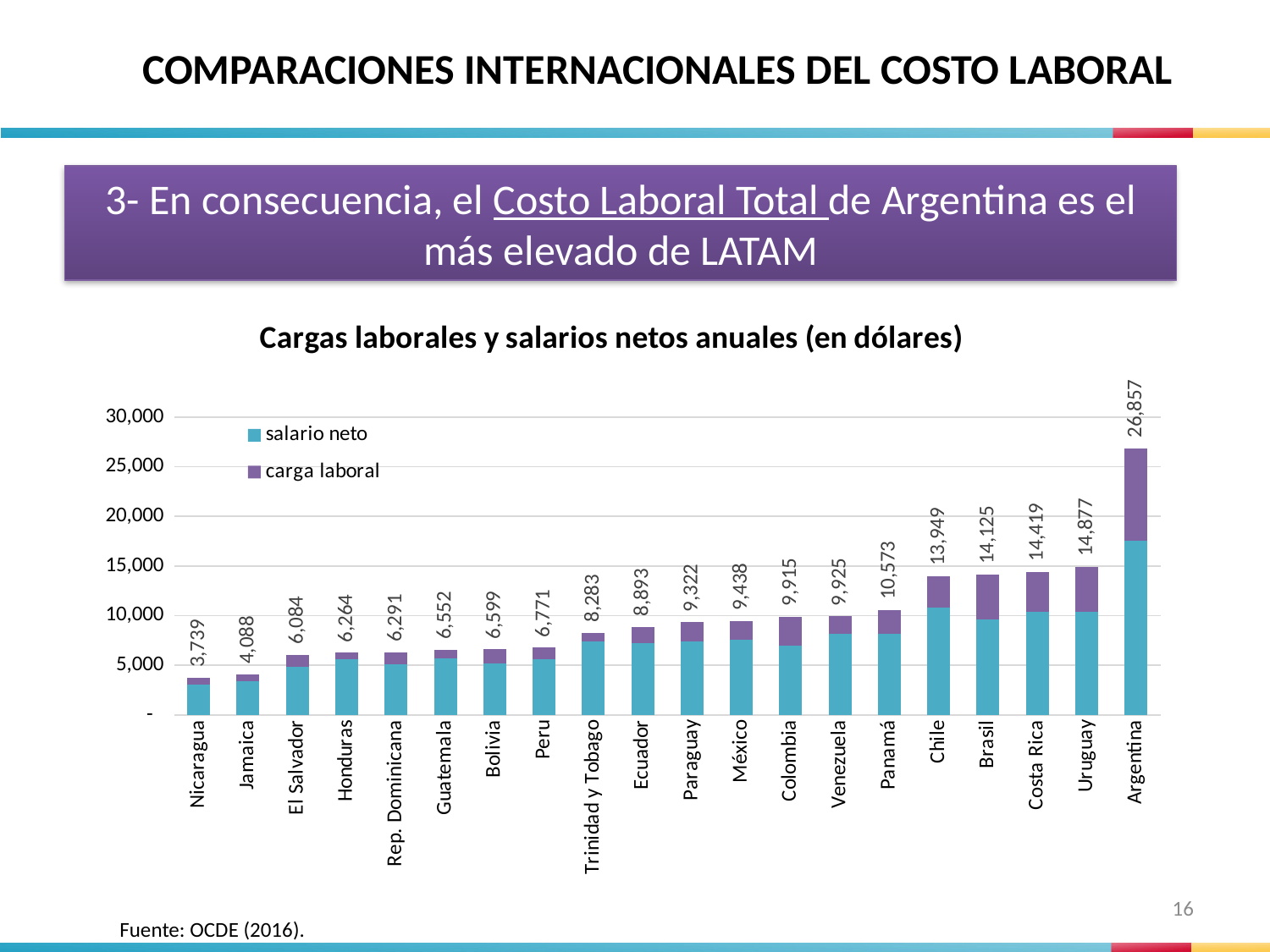
Which has a larger total value, Panamá or Venezuela? Panamá What kind of chart is shown on the slide? Stacked bar chart Is the salario neto value for Argentina greater or less than 15,000? greater How many series does the legend list? 2 What is the difference between the total values for Argentina and Uruguay? 11,980 Which country has the lowest total value in the chart? Nicaragua Do the total values rise or fall from left to right along the x axis? Rise Which country has the highest total value in the chart? Argentina What is the total labeled value for Argentina? 26,857 How many countries are shown in the chart? 20 What is the total labeled value for Nicaragua? 3,739 What is the total labeled value for Chile? 13,949